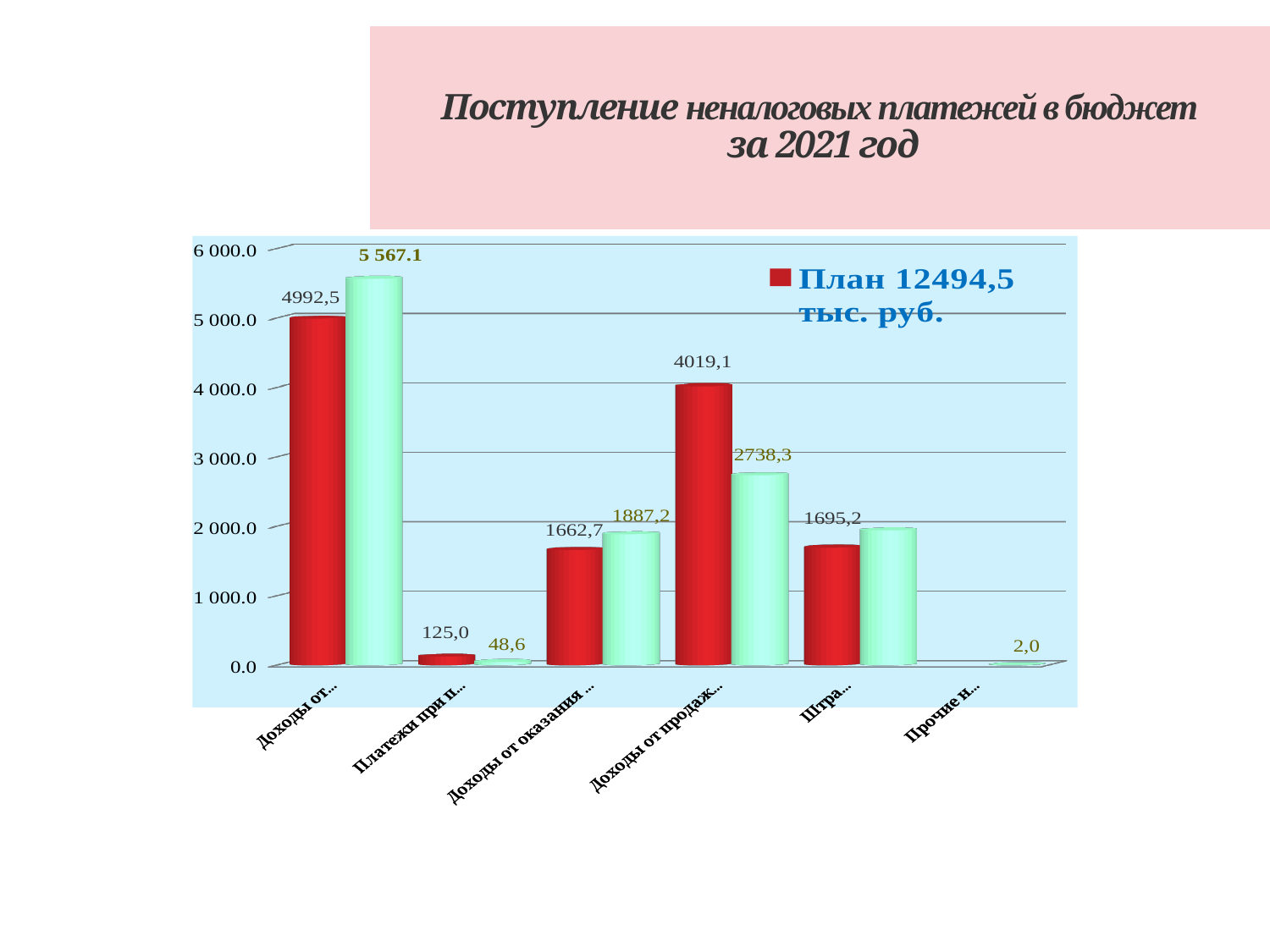
What is the value of the light green bar for the category 'Прочие н...'? 2,0 Is the value of the light green bar for the category 'Штра...' greater or less than 1 000? greater What is the value of the light green bar for the first category (Доходы от...)? 5 567.1 What kind of chart is shown on the slide? bar chart Which category has the highest red bar? the first category (Доходы от...) What is the value of the red bar for the first category (Доходы от...)? 4992,5 What is the value of the light green bar for the category 'Доходы от продаж...'? 2738,3 What is the value of the red bar for the category 'Платежи при п...'? 125,0 How many categories are shown on the x axis? 6 What is the difference between the red bar (4019,1) and the light green bar (2738,3) for the category 'Доходы от продаж...'? 1280,8 For the category 'Доходы от продаж...', which bar is larger, the red one or the light green one? the red one What is the value of the red bar for the category 'Доходы от продаж...'? 4019,1